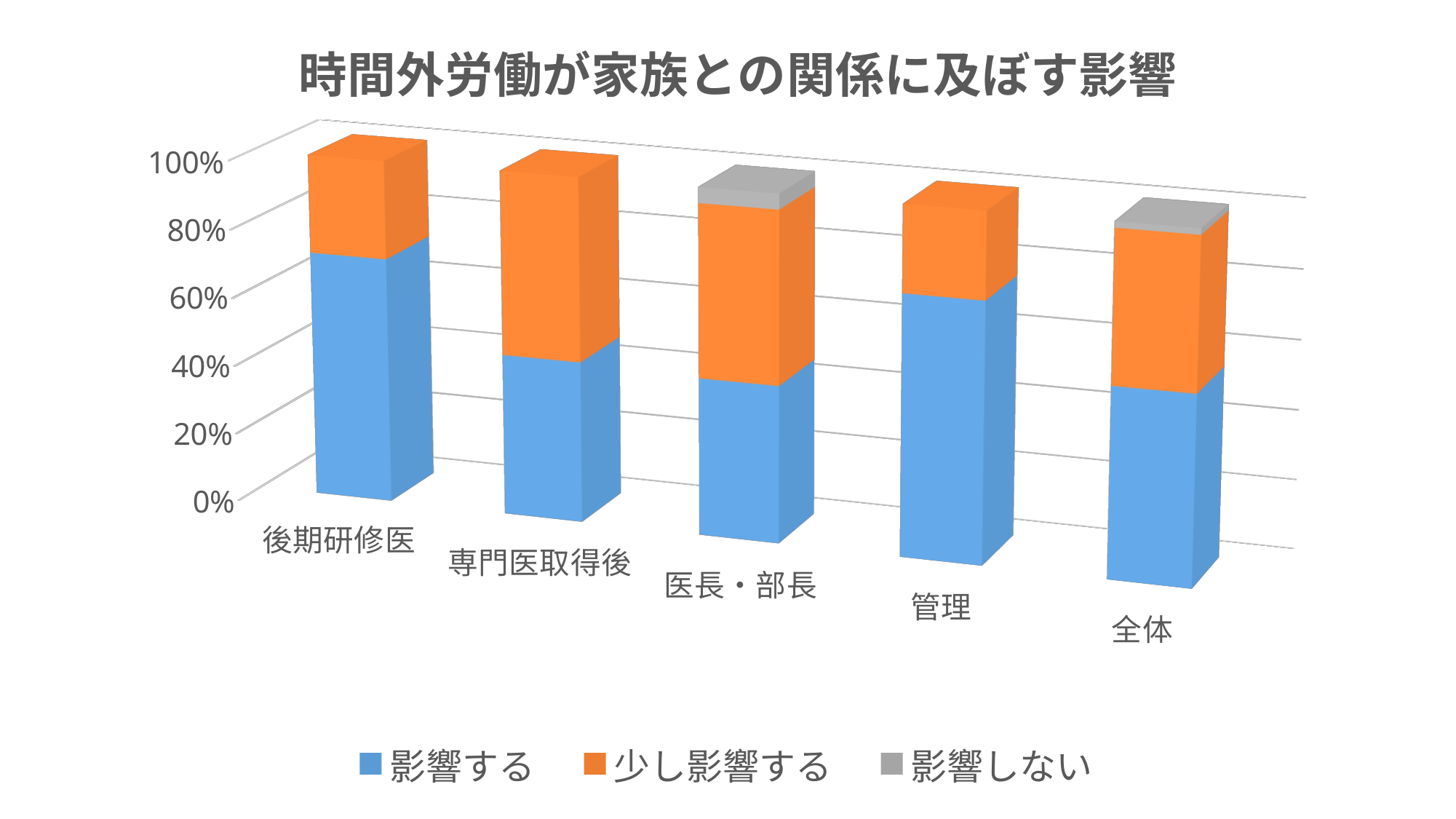
What kind of chart is shown on the slide? Stacked bar chart Is the value of 影響する for 医長・部長 greater or less than 60%? less How many categories are shown on the x axis? 5 Which series is shown in blue? 影響する Is the value of 影響する for 管理 greater or less than 60%? greater Which has a larger 影響する share, 管理 or 医長・部長? 管理 How many series does the legend list? 3 Which has a larger 影響する share, 後期研修医 or 専門医取得後? 後期研修医 Is the value of 影響する for 後期研修医 greater or less than 60%? greater What is the title of the chart? 時間外労働が家族との関係に及ぼす影響 How many categories show a visible 影響しない segment? 2